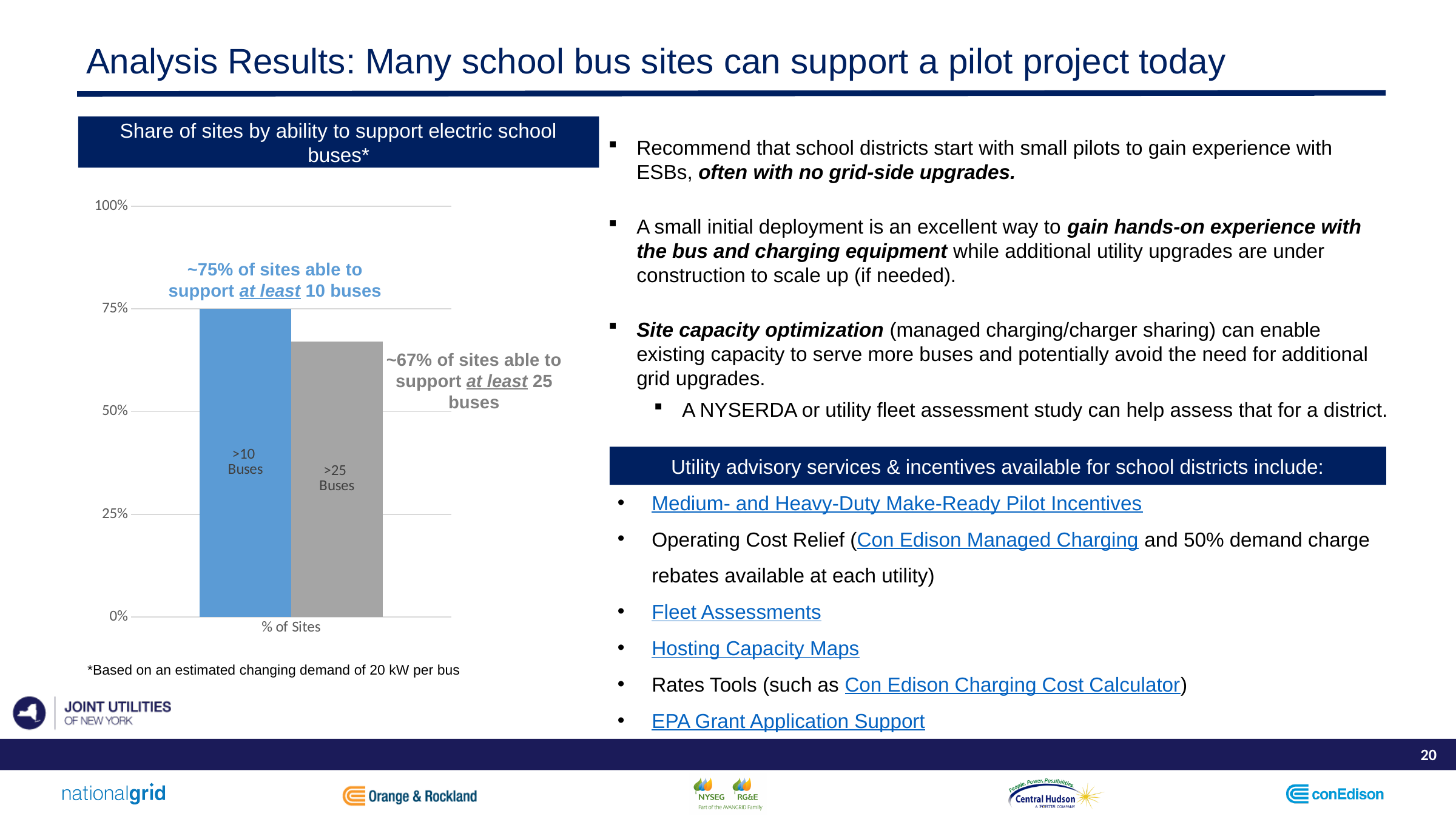
How many bars are plotted in the chart? 2 Which category has the highest share of sites? >10 Buses What kind of chart is shown on the slide? bar chart What is the label on the x axis of the chart? % of Sites Which category has the lowest share of sites? >25 Buses Which bar is taller, >10 Buses or >25 Buses? >10 Buses Is the value for >25 Buses greater or less than 50%? greater Is the value for >25 Buses greater or less than 75%? less Is the value for >10 Buses greater or less than 100%? less What is the title of the chart? Share of sites by ability to support electric school buses*